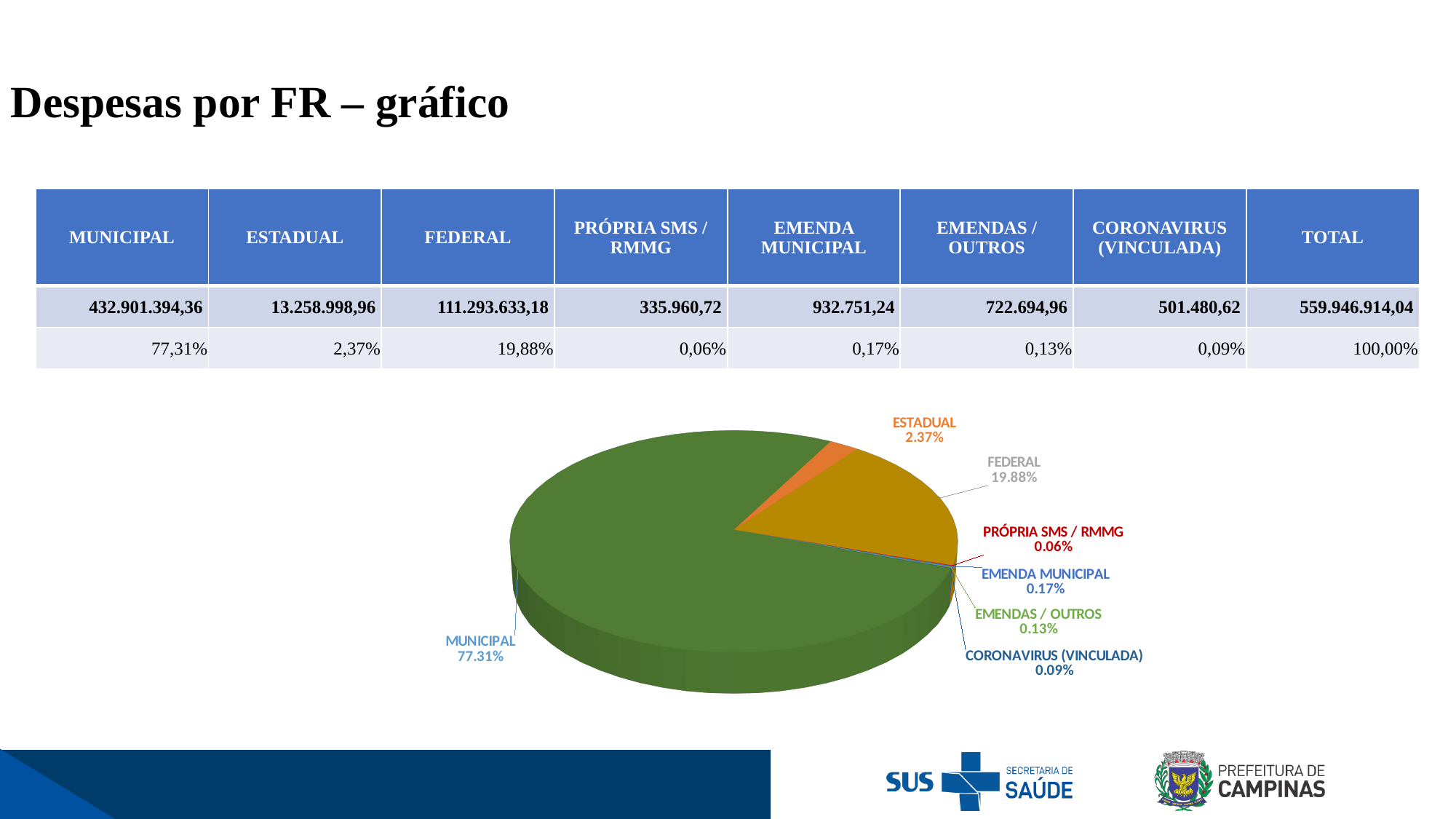
What share of the pie does MUNICIPAL have? 77.31% What colour is the MUNICIPAL slice of the pie chart? Green Which slice of the pie chart is the largest? MUNICIPAL What kind of chart is shown on the slide? Pie chart How many slices does the pie chart have? 7 What is the value shown for CORONAVIRUS (VINCULADA) in the pie chart? 0.09% Which is larger in the pie chart, FEDERAL or ESTADUAL? FEDERAL What is the difference in percentage points between MUNICIPAL and FEDERAL in the pie chart? 57.43 What is the value shown for FEDERAL in the pie chart? 19.88% Which slice of the pie chart is the smallest? PRÓPRIA SMS / RMMG What is the value shown for ESTADUAL in the pie chart? 2.37% What is the value shown for EMENDA MUNICIPAL in the pie chart? 0.17%